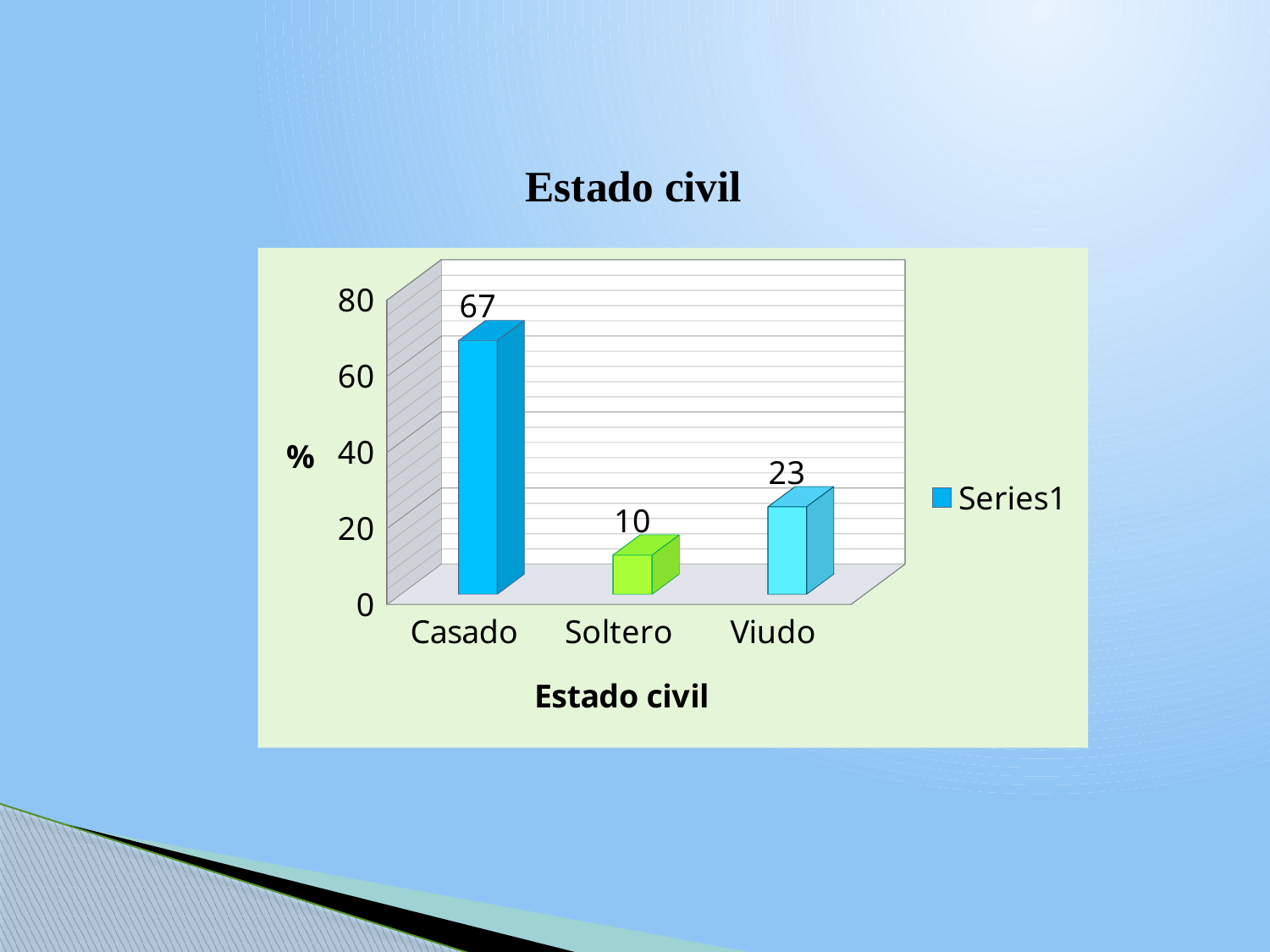
What is the difference between the values for Viudo and Soltero? 13 What is the value for Soltero? 10 Which category has the lowest value? Soltero What is the title of the chart? Estado civil Which category has the highest value? Casado What is the difference between the values for Casado and Viudo? 44 What is the value for Casado? 67 How many categories are shown on the x axis? 3 Is the value for Casado greater or less than 60? greater Which is larger, the value for Viudo or the value for Soltero? Viudo What is the value for Viudo? 23 What kind of chart is shown on the slide? bar chart